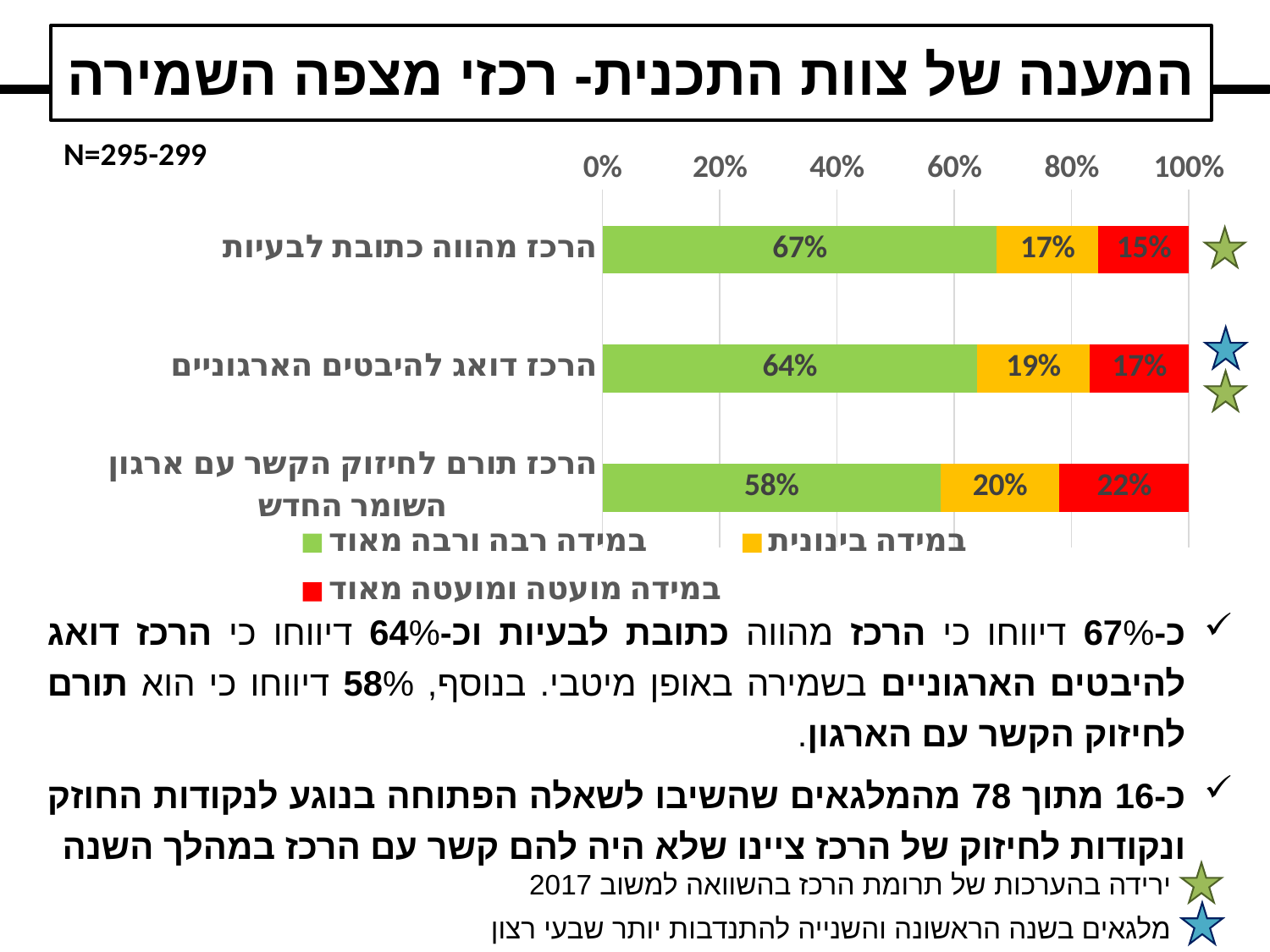
Which category has the highest value for the green series (במידה רבה ורבה מאוד)? הרכז מהווה כתובת לבעיות Which category has the lowest value for the red series (במידה מועטה ומועטה מאוד)? הרכז מהווה כתובת לבעיות What is the value of the red series (במידה מועטה ומועטה מאוד) for "הרכז תורם לחיזוק הקשר עם ארגון השומר החדש"? 22% What type of chart is shown on the slide? Stacked bar chart What is the difference between the green series values for "הרכז מהווה כתובת לבעיות" and "הרכז תורם לחיזוק הקשר עם ארגון השומר החדש"? 9% Which colour represents the series "במידה בינונית" in the chart? Yellow How many categories are plotted in the chart? 3 What is the value of the green series (במידה רבה ורבה מאוד) for "הרכז מהווה כתובת לבעיות"? 67% How many series does the chart legend list? 3 What is the value of the yellow series (במידה בינונית) for "הרכז דואג להיבטים הארגוניים"? 19% Which is larger: the yellow series value for "הרכז דואג להיבטים הארגוניים" or for "הרכז מהווה כתובת לבעיות"? הרכז דואג להיבטים הארגוניים What is the total of the stacked bar for "הרכז דואג להיבטים הארגוניים"? 100%